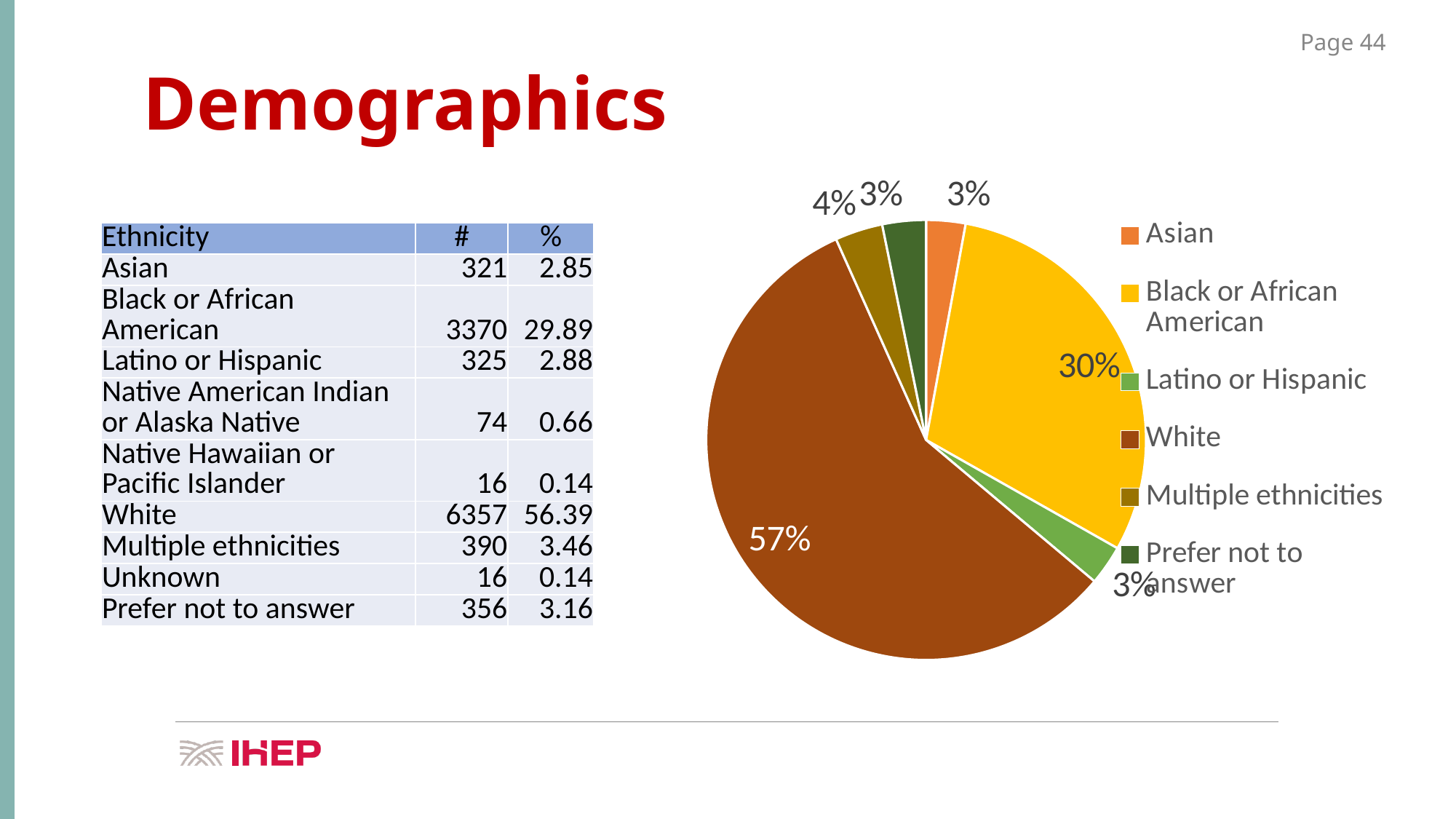
What share of the pie chart does Black or African American represent? 30% Which category has the largest slice in the pie chart? White What kind of chart is shown on the slide? pie chart What is the difference in percentage points between the White slice and the Black or African American slice? 27 What colour is the White slice in the pie chart? brown What share of the pie chart does Asian represent? 3% What is the difference in percentage points between the Multiple ethnicities slice and the Asian slice? 1 What share of the pie chart does White represent? 57% Which is larger in the pie chart, Black or African American or Multiple ethnicities? Black or African American How many slices does the pie chart have? 6 How many entries does the pie chart's legend list? 6